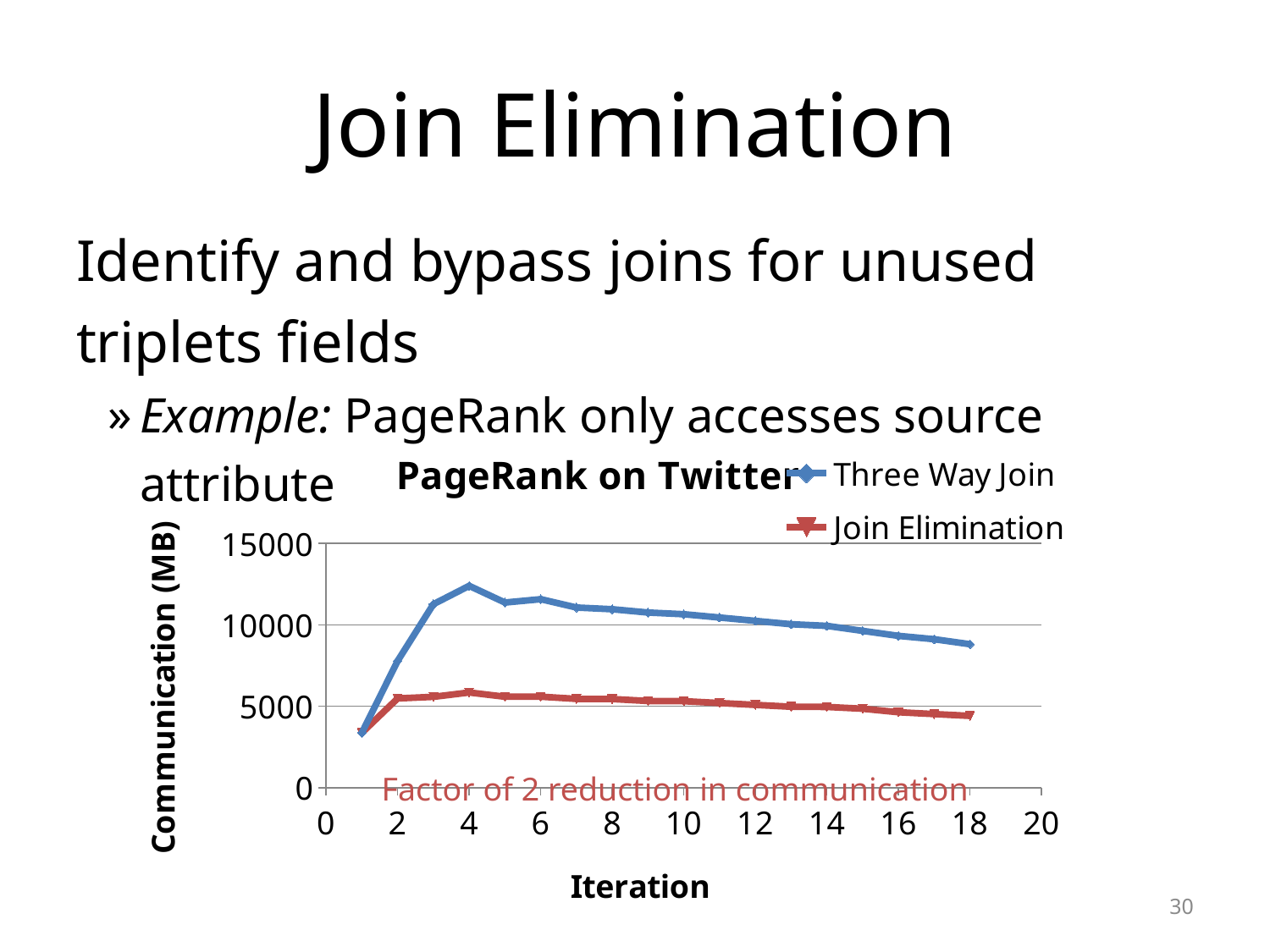
Is the value for Join Elimination at iteration 4 greater or less than 10000? less Is the value for Join Elimination at iteration 18 greater or less than 5000? less Is the value for Three Way Join at iteration 1 greater or less than 5000? less What kind of chart is shown on the slide? line chart From iteration 4 to iteration 18, does the Three Way Join series rise or fall? fall At iteration 10, which series has the higher communication value, Three Way Join or Join Elimination? Three Way Join At which iteration does the Three Way Join series reach its highest value? 4 What are the two series named in the legend? Three Way Join and Join Elimination What is the title of the chart? PageRank on Twitter How many series does the chart's legend list? 2